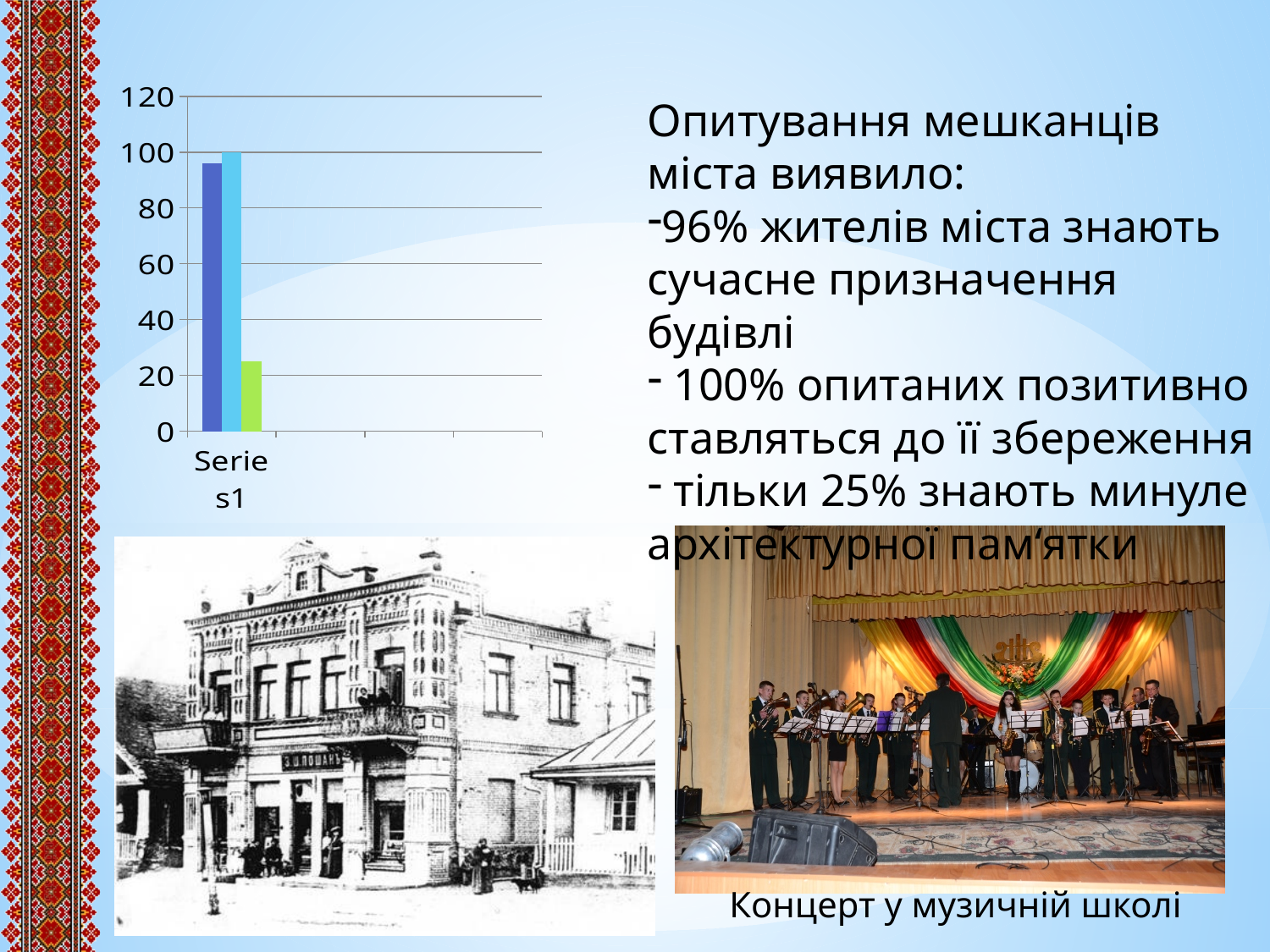
How many bars are plotted in the chart? 3 Which bar is the tallest in the chart? the light blue (middle) bar Is the value of the dark blue (left) bar greater or less than 80? greater Is the value of the green (right) bar greater or less than 40? less Which is larger, the dark blue bar or the green bar? the dark blue bar What kind of chart is shown on the slide? bar chart What is the highest value shown on the y axis of the chart? 120 What is the label of the single category on the x axis of the chart? Series1 Is the value of the green (right) bar greater or less than 60? less Which is larger, the light blue bar or the green bar? the light blue bar What value does the light blue (middle) bar reach on the y axis? 100 Which bar is the shortest in the chart? the green (right) bar